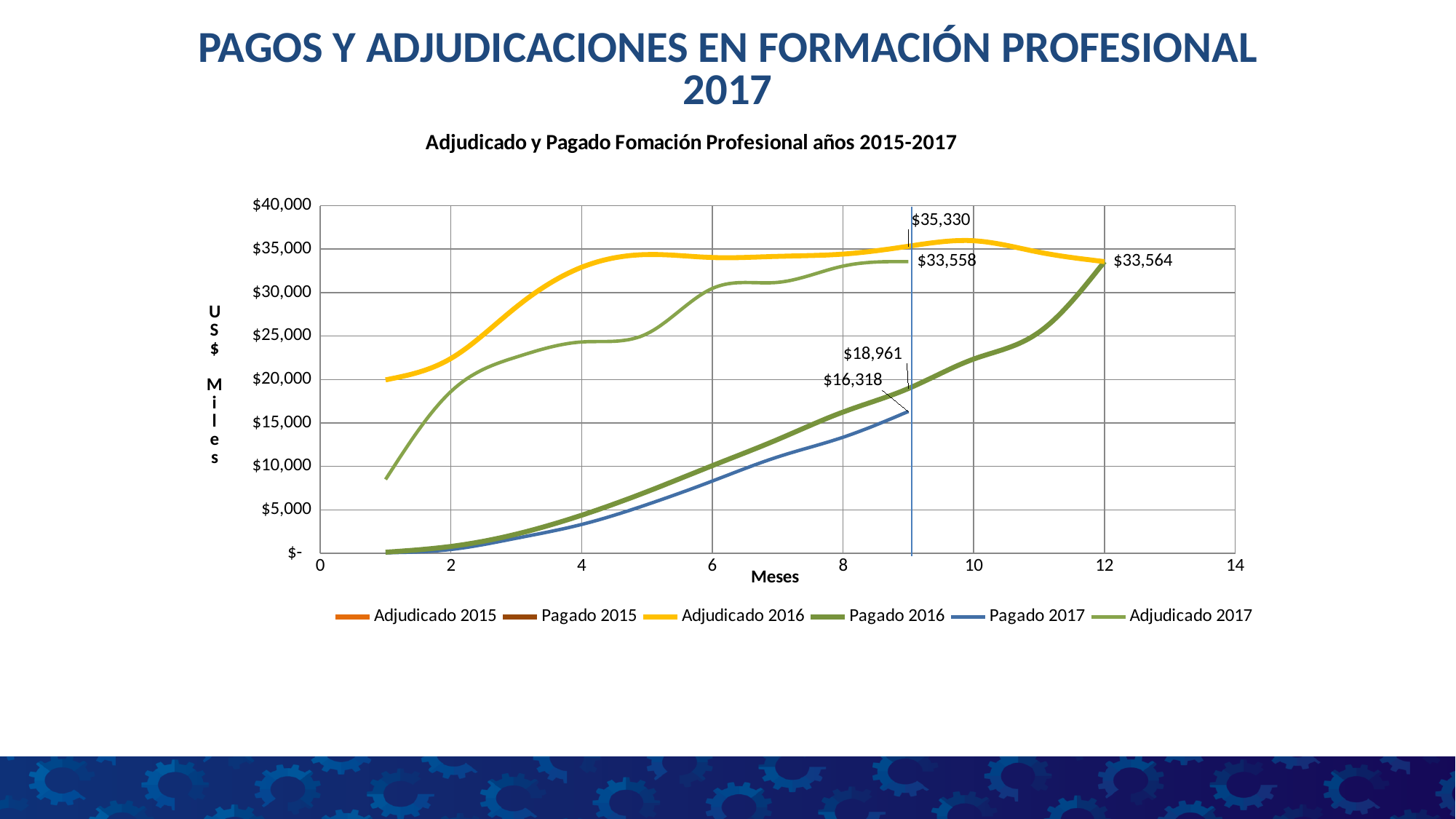
What is the labelled value for Pagado 2017 at month 9? $16,318 How many series does the legend list? 6 What kind of chart is shown on the slide? line chart Is the value for Adjudicado 2017 at month 1 greater or less than $10,000? less At month 9, what is the difference between Pagado 2016 and Pagado 2017? $2,643 What value is labelled at month 12 on the chart? $33,564 At month 9, what is the difference between Adjudicado 2016 and Adjudicado 2017? $1,772 What is the labelled value for Pagado 2016 at month 9? $18,961 Does the Pagado 2017 line rise or fall as the months increase? rises What is the labelled value for Adjudicado 2016 at month 9? $35,330 At month 9, which is larger: Adjudicado 2016 or Adjudicado 2017? Adjudicado 2016 What is the labelled value for Adjudicado 2017 at month 9? $33,558